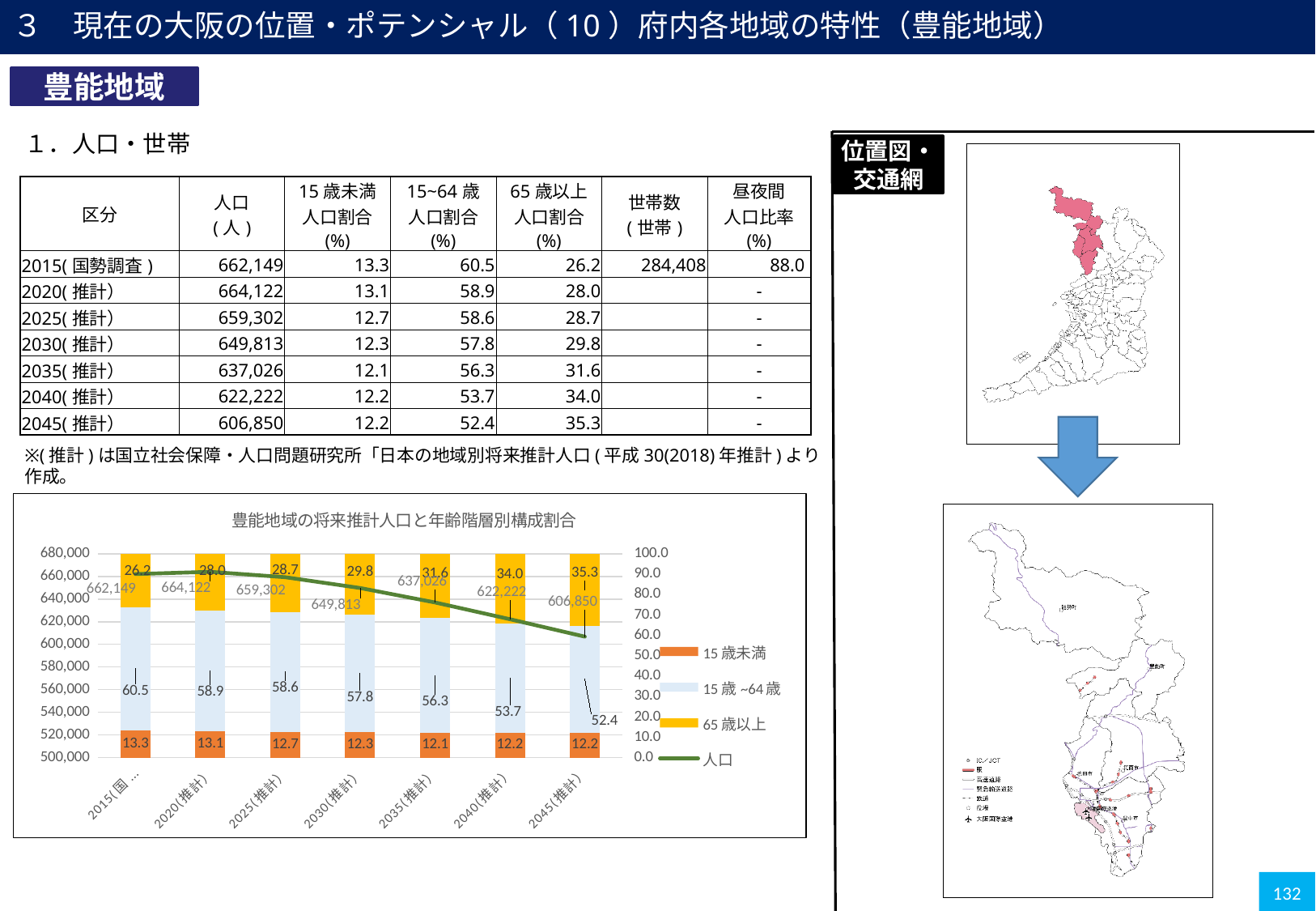
In the chart, what is the difference between the 65歳以上 share in 2045(推計) and in 2015? 9.1 How many series does the chart's legend list? 4 In the chart, is the 15歳~64歳 share larger in 2020(推計) or in 2040(推計)? 2020(推計) In the chart 豊能地域の将来推計人口と年齢階層別構成割合, what is the 65歳以上 share for 2045(推計)? 35.3 How many categories are shown on the x axis of the chart? 7 In the chart, which category has the lowest 人口 value? 2045(推計) In the chart, what is the 15歳未満 share for 2025(推計)? 12.7 In the chart, does the 65歳以上 share rise or fall from 2015 to 2045(推計)? Rise What kind of chart is 豊能地域の将来推計人口と年齢階層別構成割合? A stacked bar chart combined with a line chart In the chart, what is the total of the three stacked segments for 2015? 100.0 In the chart, what is the 人口 value for 2030(推計)? 649,813 In the chart, which category has the highest 人口 value? 2020(推計)